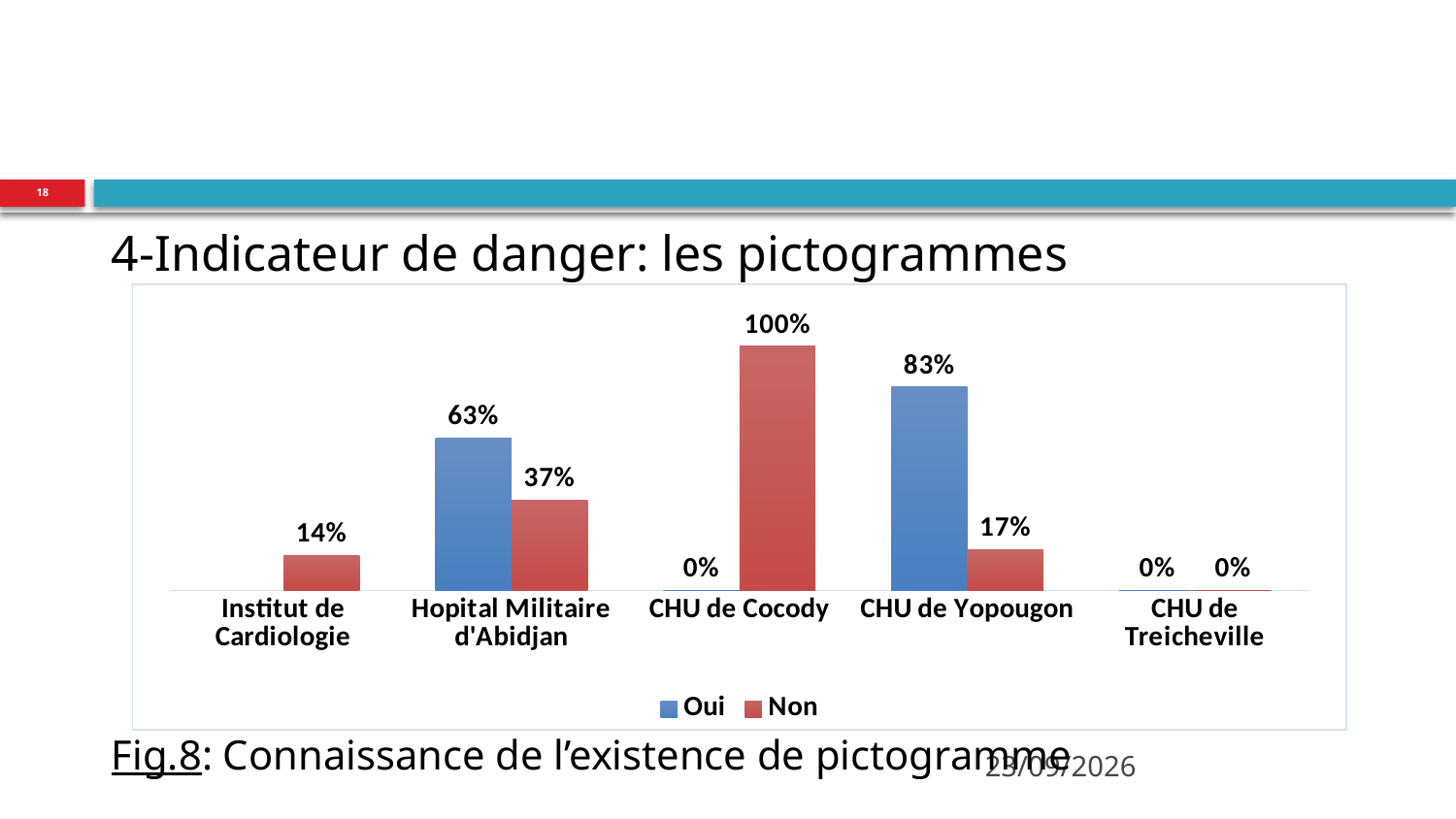
What is the Non value for CHU de Cocody? 100% What is the Oui value for Hopital Militaire d'Abidjan? 63% Which is larger for CHU de Yopougon, the Oui value or the Non value? Oui What is the Non value for Institut de Cardiologie? 14% What is the difference between the Oui and Non values for Hopital Militaire d'Abidjan? 26% What is the Non value for CHU de Treicheville? 0% How many hospitals are shown on the x axis? 5 How many series does the legend list? 2 Which hospital has the highest Oui value? CHU de Yopougon What is the Oui value for CHU de Yopougon? 83% Which hospital has the highest Non value? CHU de Cocody What kind of chart is shown on the slide? Bar chart